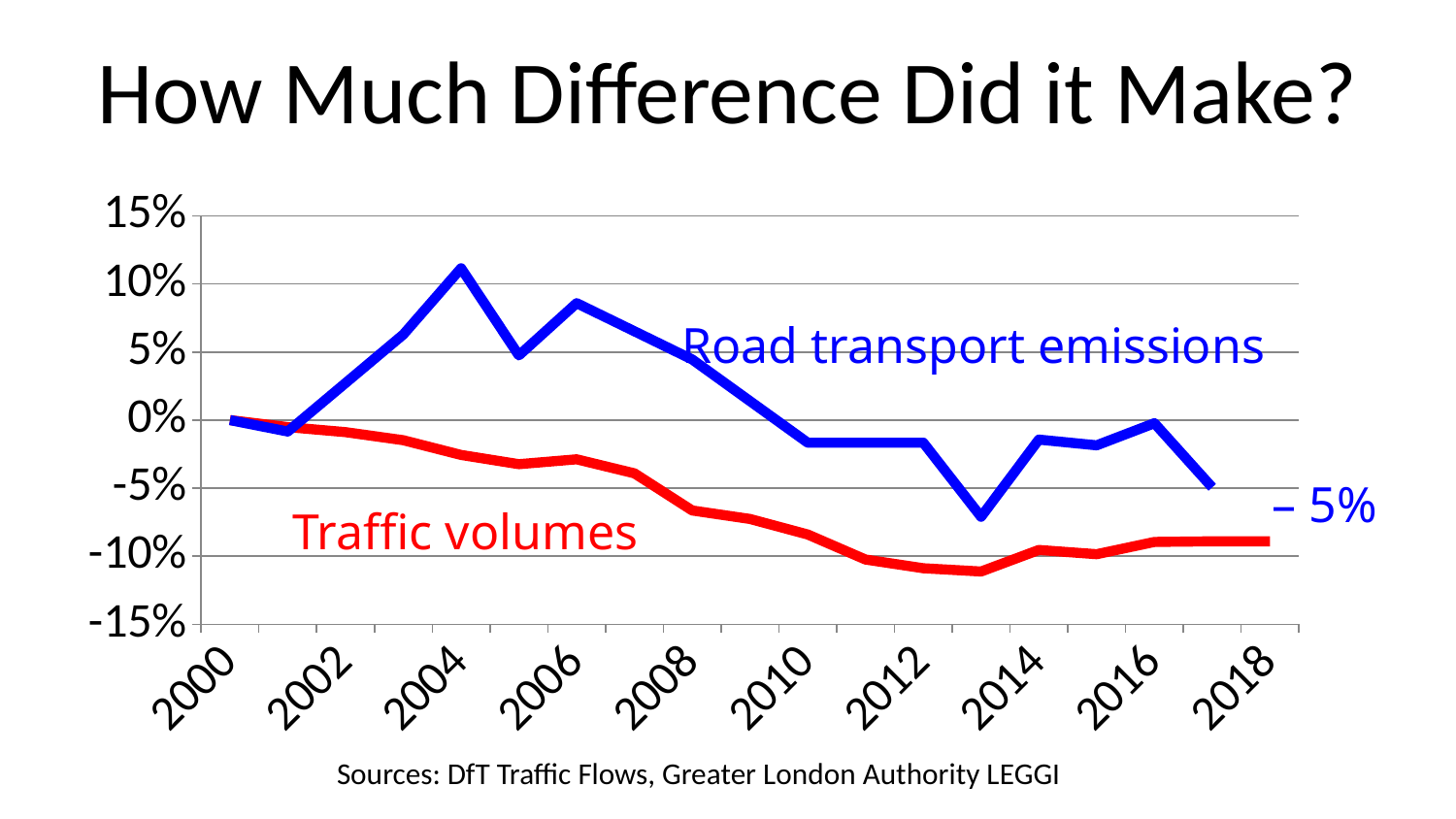
In 2010, which series has the higher value, Road transport emissions or Traffic volumes? Road transport emissions What kind of chart is shown on the slide? line chart In which year does the Road transport emissions line reach its lowest point? 2013 Is the value for Traffic volumes in 2012 greater or less than -10%? less How many data series are plotted on the chart? 2 What colour is the Traffic volumes line? red Is the value for Road transport emissions in 2004 greater or less than 10%? greater What value is printed at the end of the Road transport emissions line? – 5% Do Traffic volumes rise or fall between 2000 and 2012? fall Is the value for Road transport emissions in 2006 greater or less than 5%? greater In which year does the Road transport emissions line reach its highest point? 2004